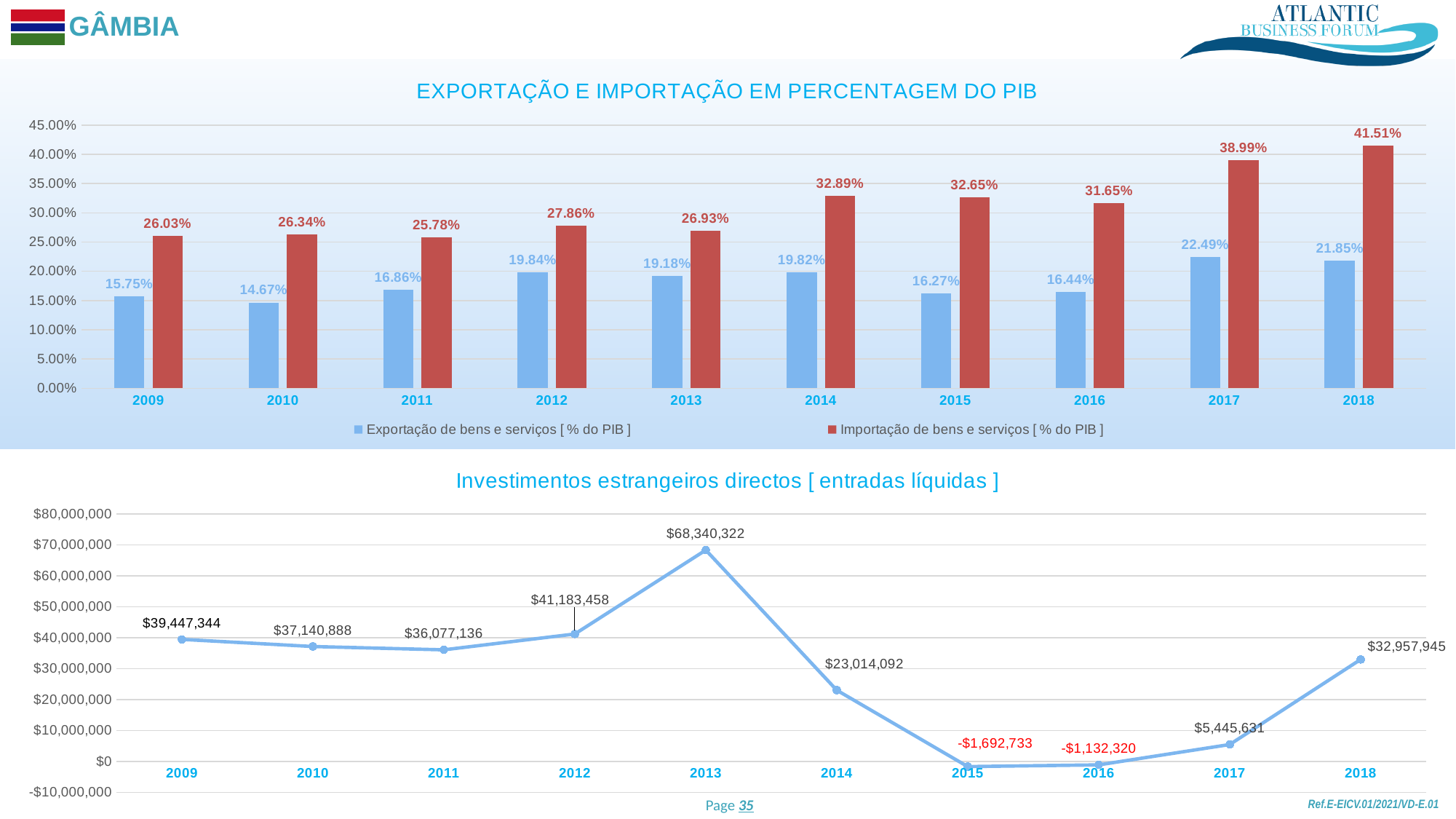
In the chart 'EXPORTAÇÃO E IMPORTAÇÃO EM PERCENTAGEM DO PIB', which year has the highest Exportação de bens e serviços value? 2017 In the chart 'EXPORTAÇÃO E IMPORTAÇÃO EM PERCENTAGEM DO PIB', what is the value of Exportação de bens e serviços in 2012? 19.84% In the chart 'Investimentos estrangeiros directos [ entradas líquidas ]', what is the difference between the 2013 and 2014 values? $45,326,230 In the chart 'EXPORTAÇÃO E IMPORTAÇÃO EM PERCENTAGEM DO PIB', which year has the lowest Exportação de bens e serviços value? 2010 In the chart 'Investimentos estrangeiros directos [ entradas líquidas ]', what is the value for 2013? $68,340,322 In the chart 'EXPORTAÇÃO E IMPORTAÇÃO EM PERCENTAGEM DO PIB', what is the difference between Importação and Exportação in 2018? 19.66% In the chart 'Investimentos estrangeiros directos [ entradas líquidas ]', how many years are plotted on the x axis? 10 In the chart 'EXPORTAÇÃO E IMPORTAÇÃO EM PERCENTAGEM DO PIB', how many series does the legend list? 2 In the chart 'Investimentos estrangeiros directos [ entradas líquidas ]', is the value for 2017 greater or less than $10,000,000? less In the chart 'Investimentos estrangeiros directos [ entradas líquidas ]', which year has the lowest value? 2015 In the chart 'EXPORTAÇÃO E IMPORTAÇÃO EM PERCENTAGEM DO PIB', what is the value of Importação de bens e serviços in 2018? 41.51% What kind of chart is 'EXPORTAÇÃO E IMPORTAÇÃO EM PERCENTAGEM DO PIB'? Bar chart